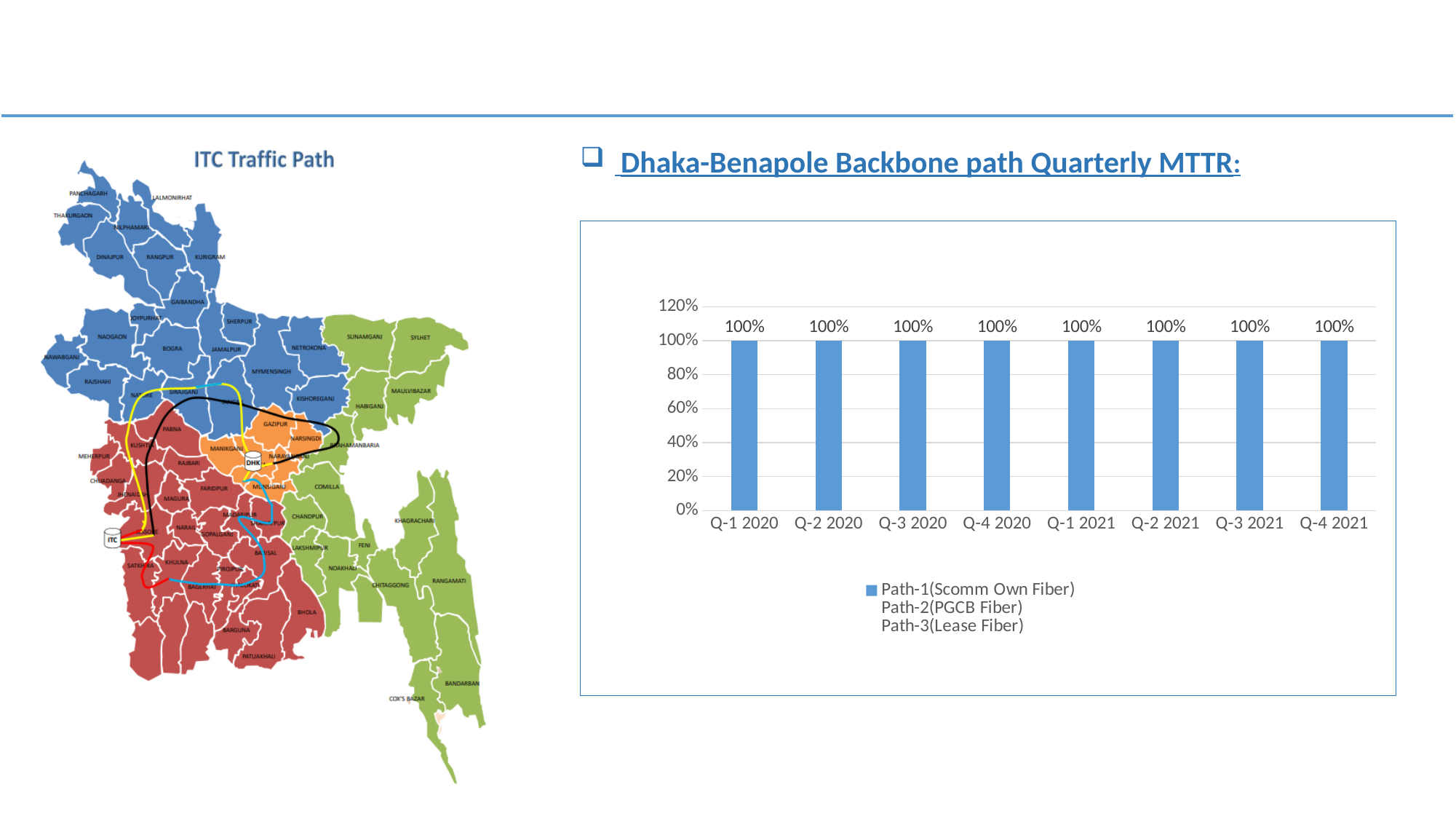
In the Dhaka-Benapole Backbone path Quarterly MTTR chart, is the value for Q-2 2020 greater or less than 80%? greater In the Dhaka-Benapole Backbone path Quarterly MTTR chart, what is the difference between the values for Q-1 2020 and Q-4 2021? 0% In the Dhaka-Benapole Backbone path Quarterly MTTR chart, what is the value for Q-3 2020? 100% In the Dhaka-Benapole Backbone path Quarterly MTTR chart, do the values rise, fall, or stay the same from Q-1 2020 to Q-4 2021? stay the same In the Dhaka-Benapole Backbone path Quarterly MTTR chart, what is the value for Q-2 2021? 100% In the Dhaka-Benapole Backbone path Quarterly MTTR chart, what is the value for Q-1 2020? 100% What colour are the bars in the Dhaka-Benapole Backbone path Quarterly MTTR chart? blue What is the highest tick value shown on the y axis of the Dhaka-Benapole Backbone path Quarterly MTTR chart? 120% How many series does the legend of the Dhaka-Benapole Backbone path Quarterly MTTR chart list? 1 In the Dhaka-Benapole Backbone path Quarterly MTTR chart, what is the value for Q-4 2021? 100% What kind of chart is shown under the title "Dhaka-Benapole Backbone path Quarterly MTTR"? bar chart How many quarters are plotted on the x axis of the Dhaka-Benapole Backbone path Quarterly MTTR chart? 8